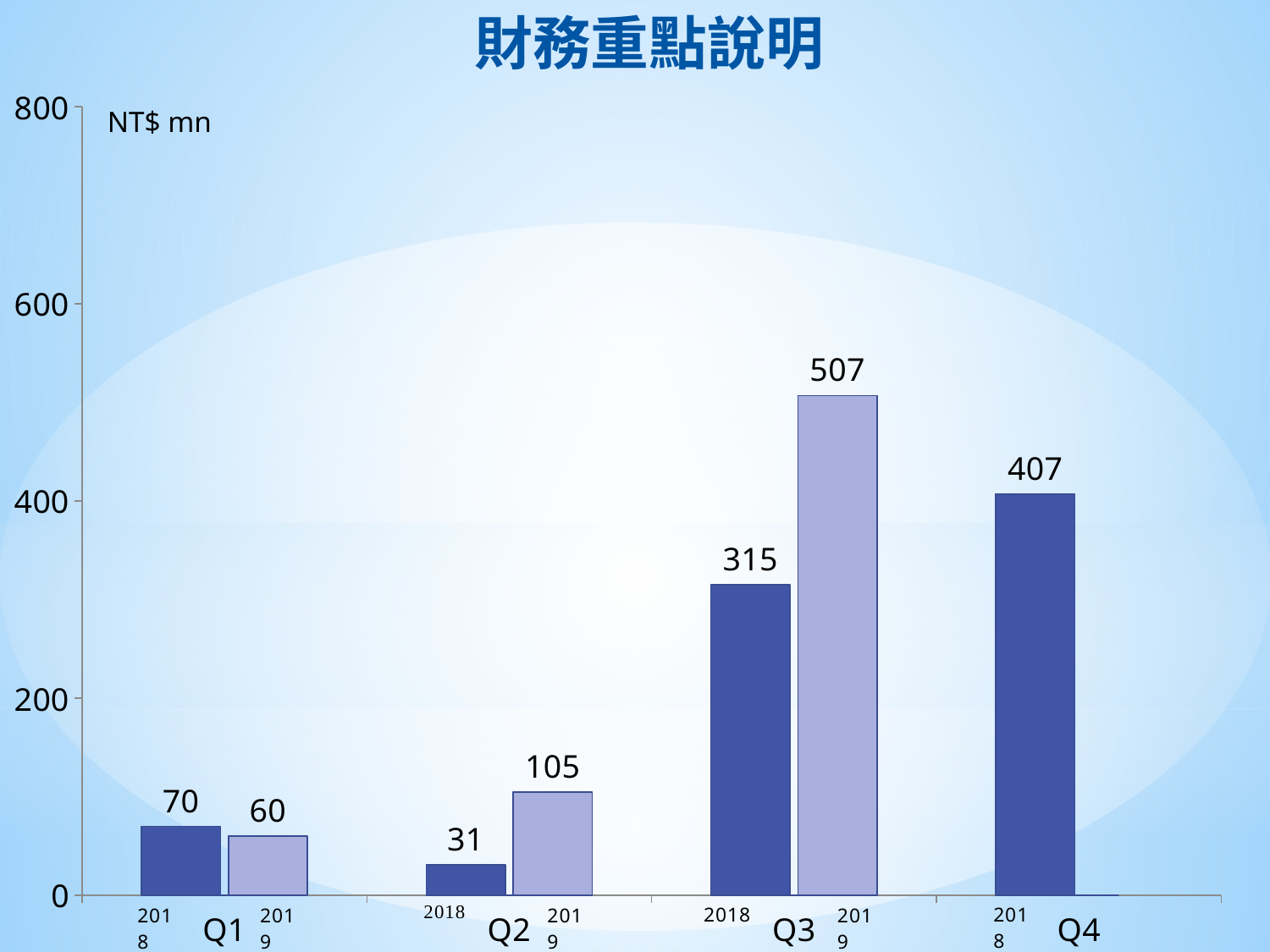
What kind of chart is shown on the slide? Bar chart What is the difference between the Q2 2019 value and the Q2 2018 value? 74 What is the value for Q4 2018? 407 What is the value for Q3 2019? 507 Which bar has the highest value on the chart? Q3 2019 What is the difference between the Q3 2019 value and the Q3 2018 value? 192 Which bar has the lowest value on the chart? Q2 2018 Which is larger, the Q1 2018 value or the Q1 2019 value? Q1 2018 What is the value for Q1 2019? 60 What is the value for Q2 2018? 31 Is the value for Q4 2018 greater or less than 400? greater What unit is shown on the chart? NT$ mn